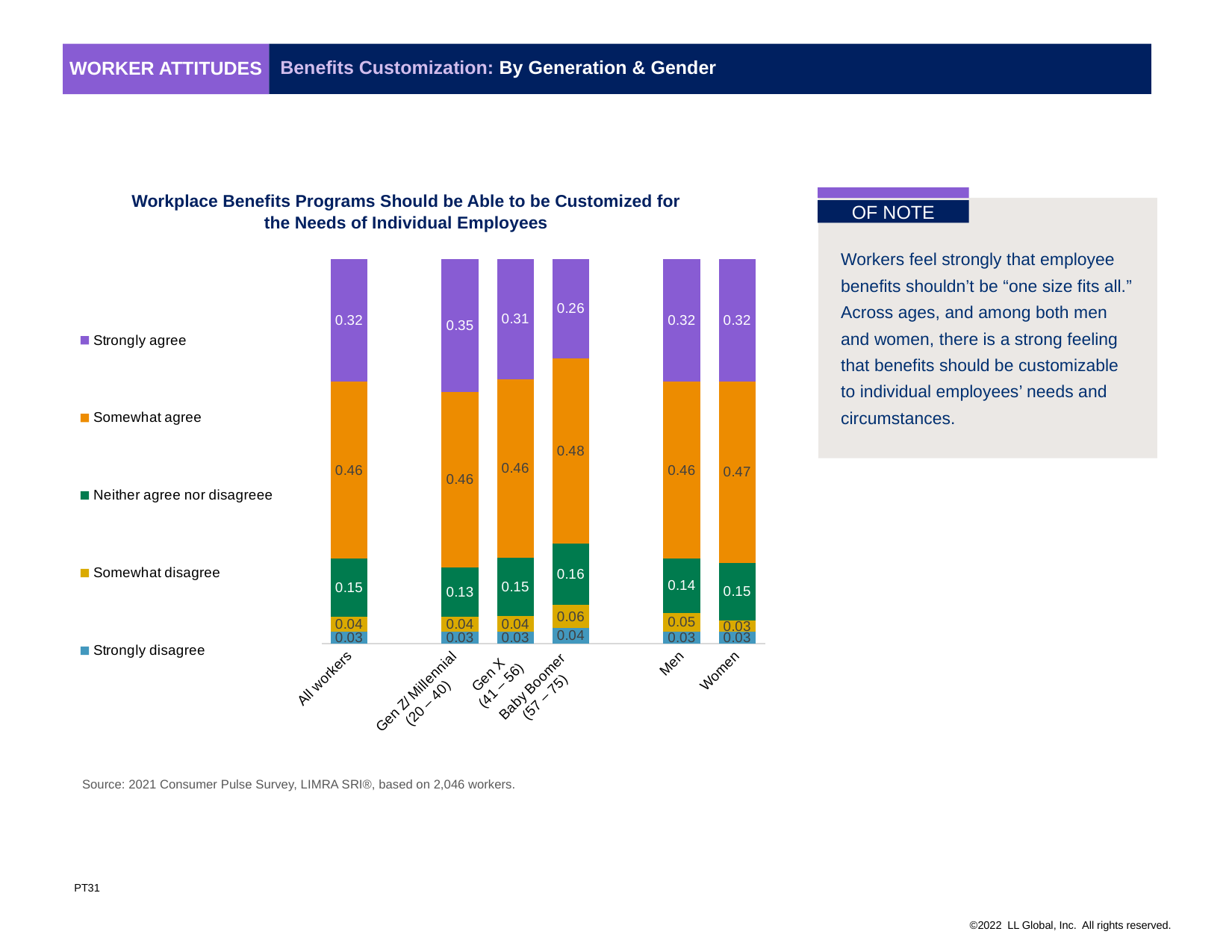
What is the Neither agree nor disagree value for Men? 0.14 What is the Somewhat agree value for Baby Boomer (57 – 75)? 0.48 How many series does the legend list? 5 What is the total of the stacked bar for Baby Boomer (57 – 75)? 1.00 What is the Strongly agree value for Gen Z/Millennial (20 – 40)? 0.35 What kind of chart is shown on the slide? Stacked bar chart What is the difference between the Strongly agree values for Gen Z/Millennial (20 – 40) and Baby Boomer (57 – 75)? 0.09 How many categories are shown on the x axis? 6 Which category has the lowest Strongly agree value? Baby Boomer (57 – 75) Which category has the highest Strongly agree value? Gen Z/Millennial (20 – 40) What is the Somewhat disagree value for Women? 0.03 Which is larger, the Somewhat disagree value for Baby Boomer (57 – 75) or for Men? Baby Boomer (57 – 75)